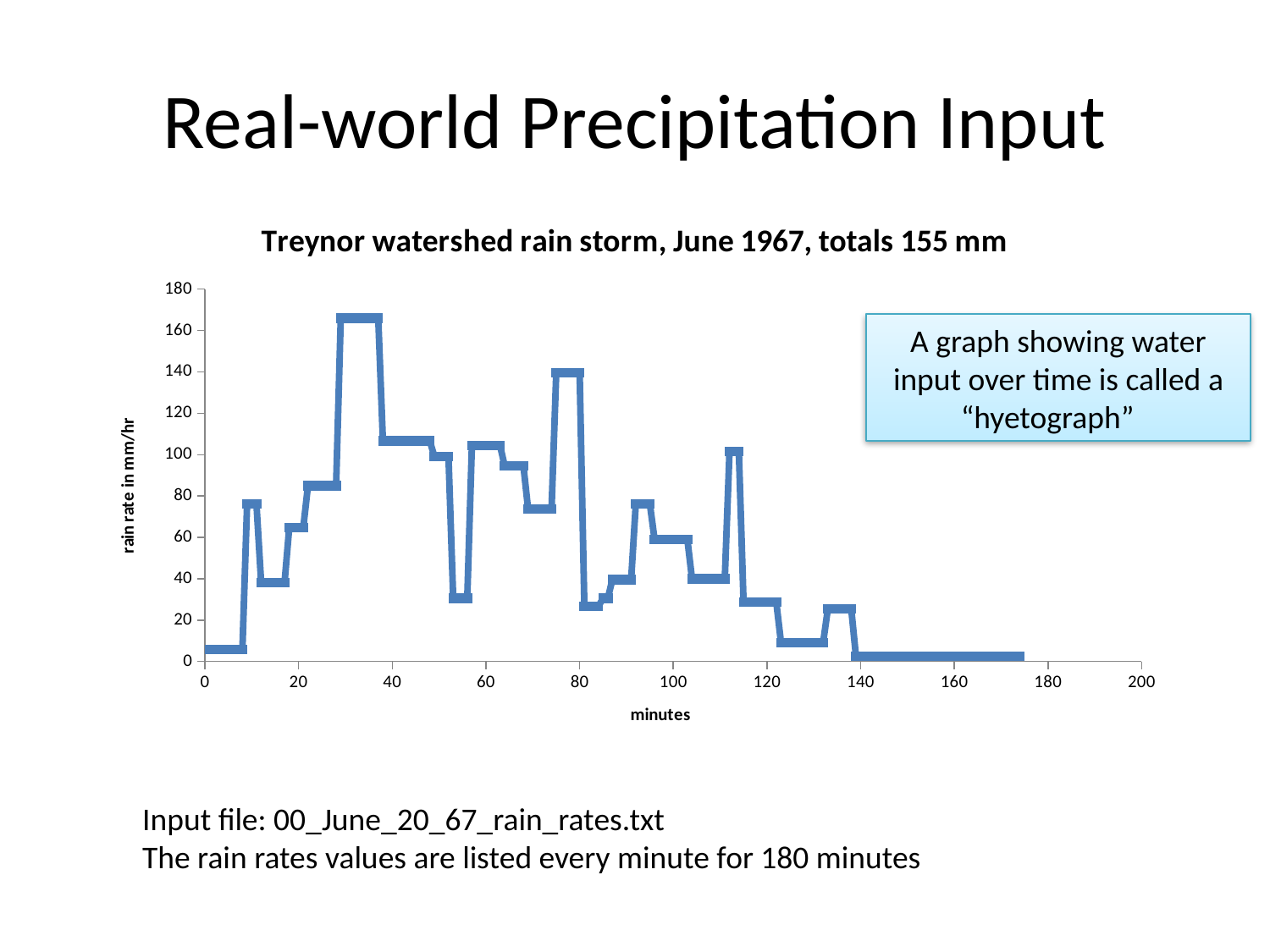
Is the rain rate at 150 minutes greater or less than 20? less What is the label of the y axis of the chart? rain rate in mm/hr What is the title of the chart? Treynor watershed rain storm, June 1967, totals 155 mm Is the rain rate at 120 minutes greater or less than 40? less What kind of chart is shown on the slide? line chart Is the highest rain rate shown on the chart greater or less than 160? greater Between 0 and 30 minutes, does the rain rate generally rise or fall? rise Which is larger, the rain rate at 60 minutes or the rain rate at 120 minutes? 60 minutes